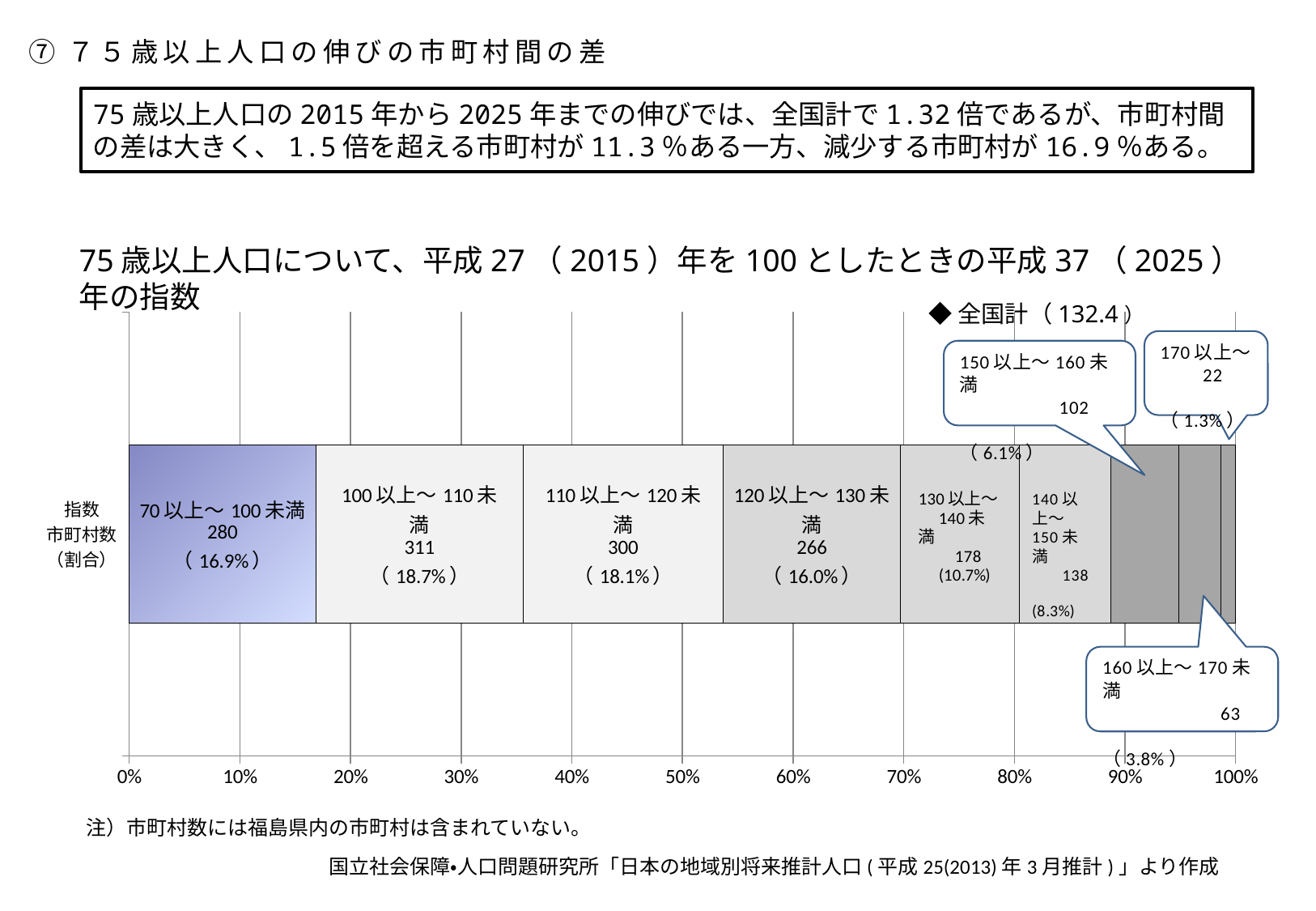
What is the combined number of municipalities in the 150以上～160未満 and 160以上～170未満 categories? 165 What percentage is shown for the 160以上～170未満 category? 3.8% How many municipalities are in the 170以上～ category? 22 How many index categories are shown in the bar? 9 What share of municipalities is in the 70以上～100未満 category? 16.9% What type of chart is shown on the slide? stacked bar chart Which category has the smallest number of municipalities? 170以上～ What is the national total (全国計) index value shown on the chart? 132.4 How many municipalities fall in the 100以上～110未満 category? 311 Which has more municipalities, the 130以上～140未満 category or the 140以上～150未満 category? 130以上～140未満 What is the difference in the number of municipalities between the 110以上～120未満 and 120以上～130未満 categories? 34 Which category has the largest number of municipalities? 100以上～110未満